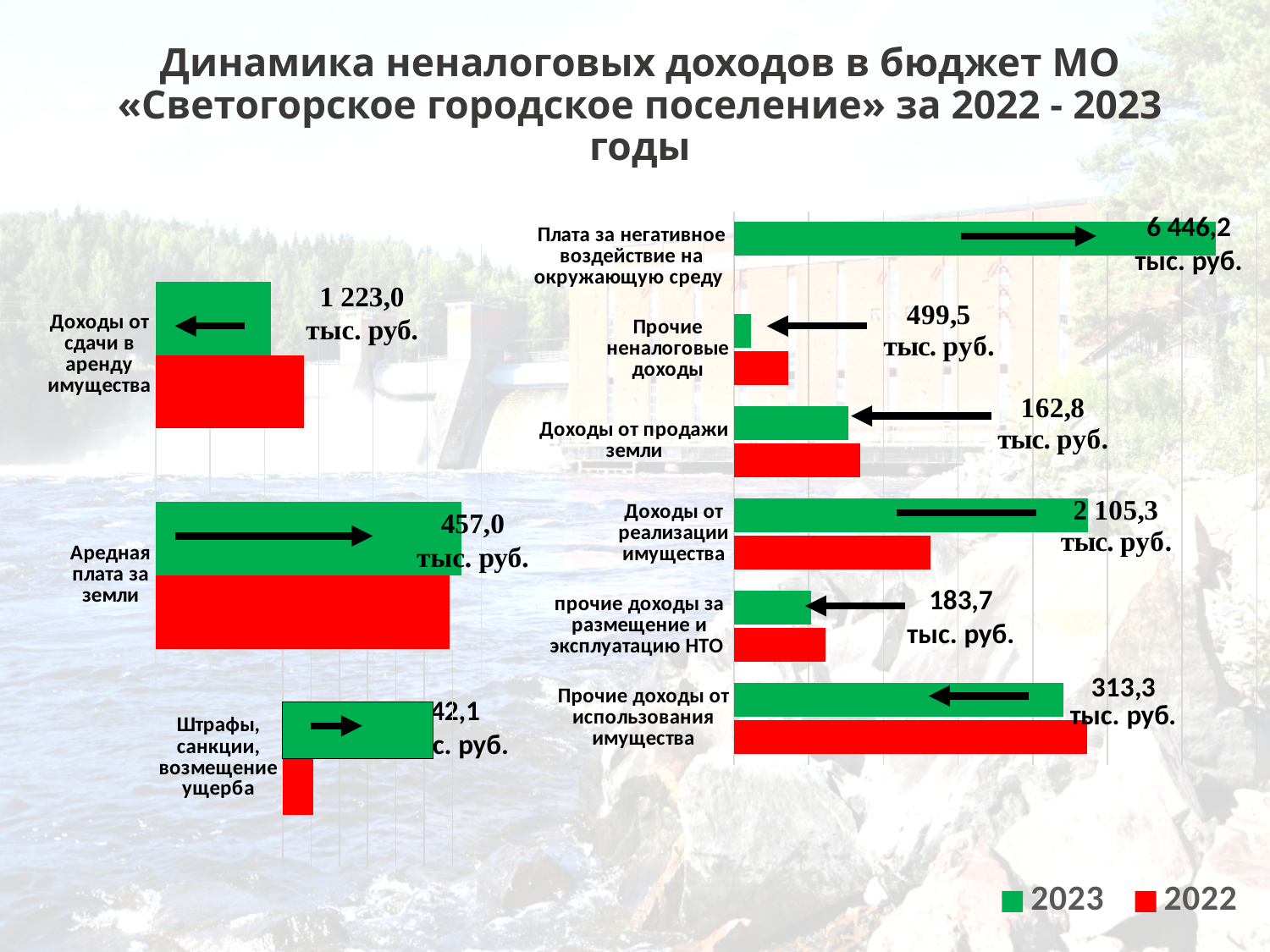
In the right-hand chart, which category has the shortest 2023 bar? Прочие неналоговые доходы In the left-hand chart, what value is printed for 'Доходы от сдачи в аренду имущества'? 1 223,0 тыс. руб. In the left-hand chart, for 'Штрафы, санкции, возмещение ущерба', which year has the larger bar, 2023 or 2022? 2023 In the legend, which year is shown in green? 2023 In the right-hand chart, what value is printed for 'Плата за негативное воздействие на окружающую среду'? 6 446,2 тыс. руб. In the right-hand chart, for 'Прочие неналоговые доходы', which year has the larger bar, 2023 or 2022? 2022 In the right-hand chart, which category has the longest 2023 bar? Плата за негативное воздействие на окружающую среду How many categories are shown in the right-hand chart? 6 What kind of chart is used on the left side of the slide? bar chart How many series does the legend at the bottom of the slide list? 2 In the right-hand chart, what value is printed for 'Доходы от реализации имущества'? 2 105,3 тыс. руб.